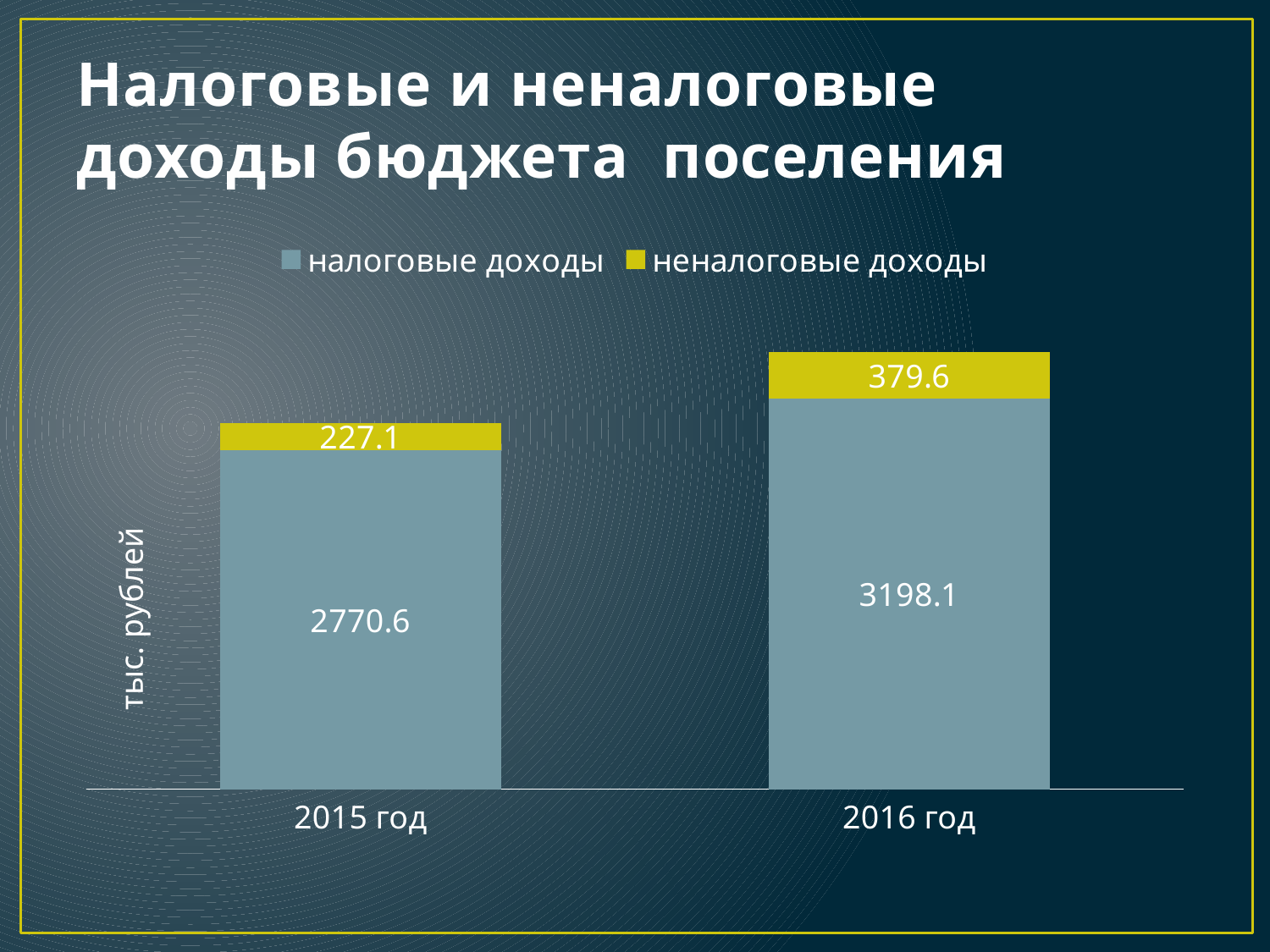
What is the value of налоговые доходы for 2016 год? 3198.1 What is the difference in неналоговые доходы between 2016 год and 2015 год? 152.5 Which year has the lower value of неналоговые доходы? 2015 год What is the value of неналоговые доходы for 2015 год? 227.1 By how much did налоговые доходы increase from 2015 год to 2016 год? 427.5 What is the total of the stacked bar for 2016 год? 3577.7 Which year has the higher value of налоговые доходы? 2016 год What kind of chart is shown on the slide? Stacked bar chart What is the value of неналоговые доходы for 2016 год? 379.6 What is the total of the stacked bar for 2015 год? 2997.7 What is the value of налоговые доходы for 2015 год? 2770.6 How many series does the legend list? 2